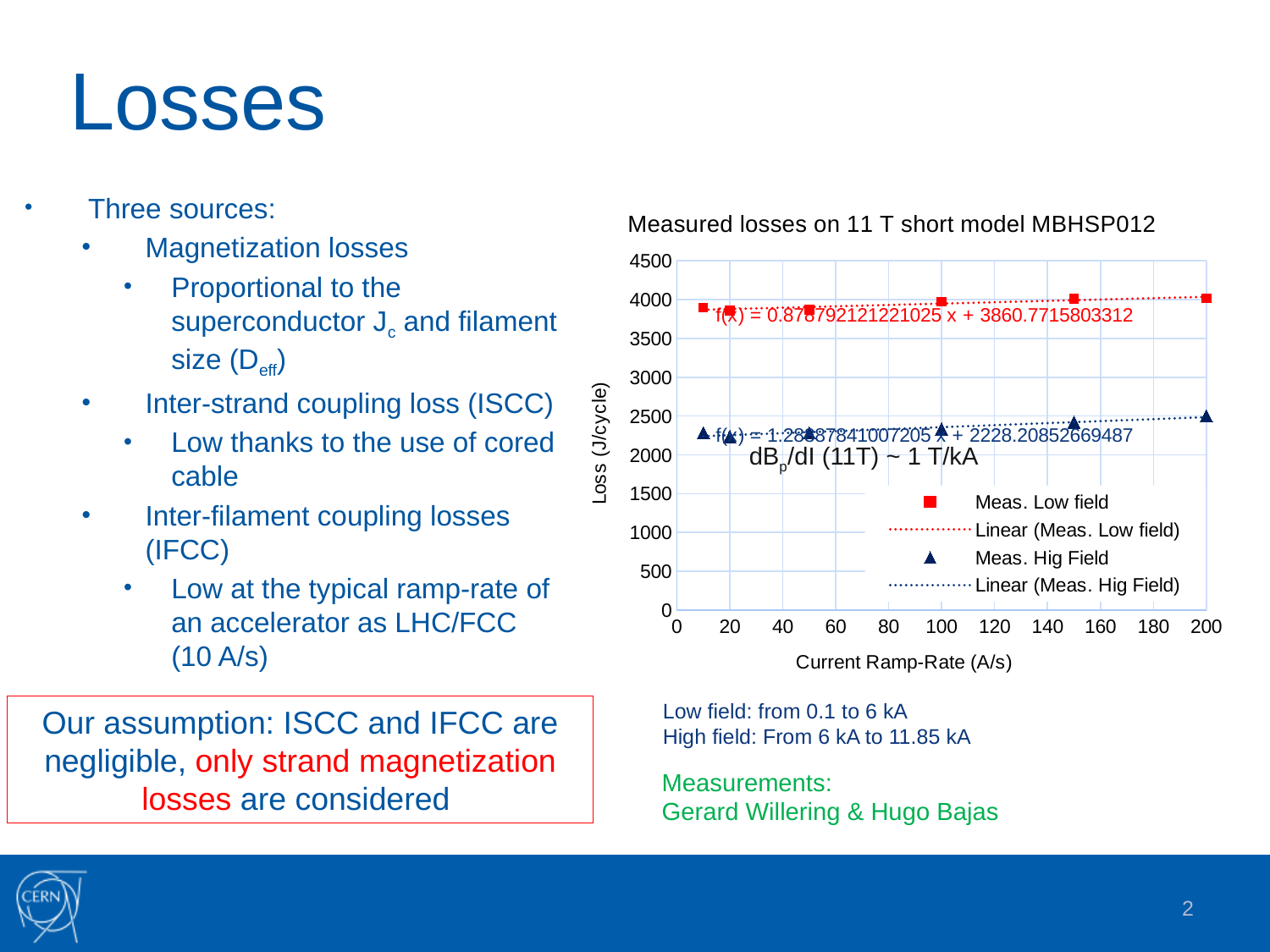
Is the Meas. Hig Field value at a ramp-rate of 200 A/s greater or less than 3000 J/cycle? less What is the intercept of the linear fit equation shown for the Meas. Hig Field series? 2228.20852669487 How many measured data points are plotted for the Meas. Low field series? 6 What is the title of the chart? Measured losses on 11 T short model MBHSP012 Is the Meas. Hig Field value at a ramp-rate of 10 A/s greater or less than 2000 J/cycle? greater What kind of chart is shown on the slide? scatter chart What is the label of the chart's x axis? Current Ramp-Rate (A/s) How many entries does the chart legend list? 4 What is the intercept of the linear fit equation shown for the Meas. Low field series? 3860.7715803312 At a ramp-rate of 200 A/s, which series has the larger loss: Meas. Low field or Meas. Hig Field? Meas. Low field Is the Meas. Low field value at a ramp-rate of 200 A/s greater or less than 3500 J/cycle? greater Do the Meas. Hig Field losses rise or fall as the current ramp-rate increases from 0 to 200 A/s? rise